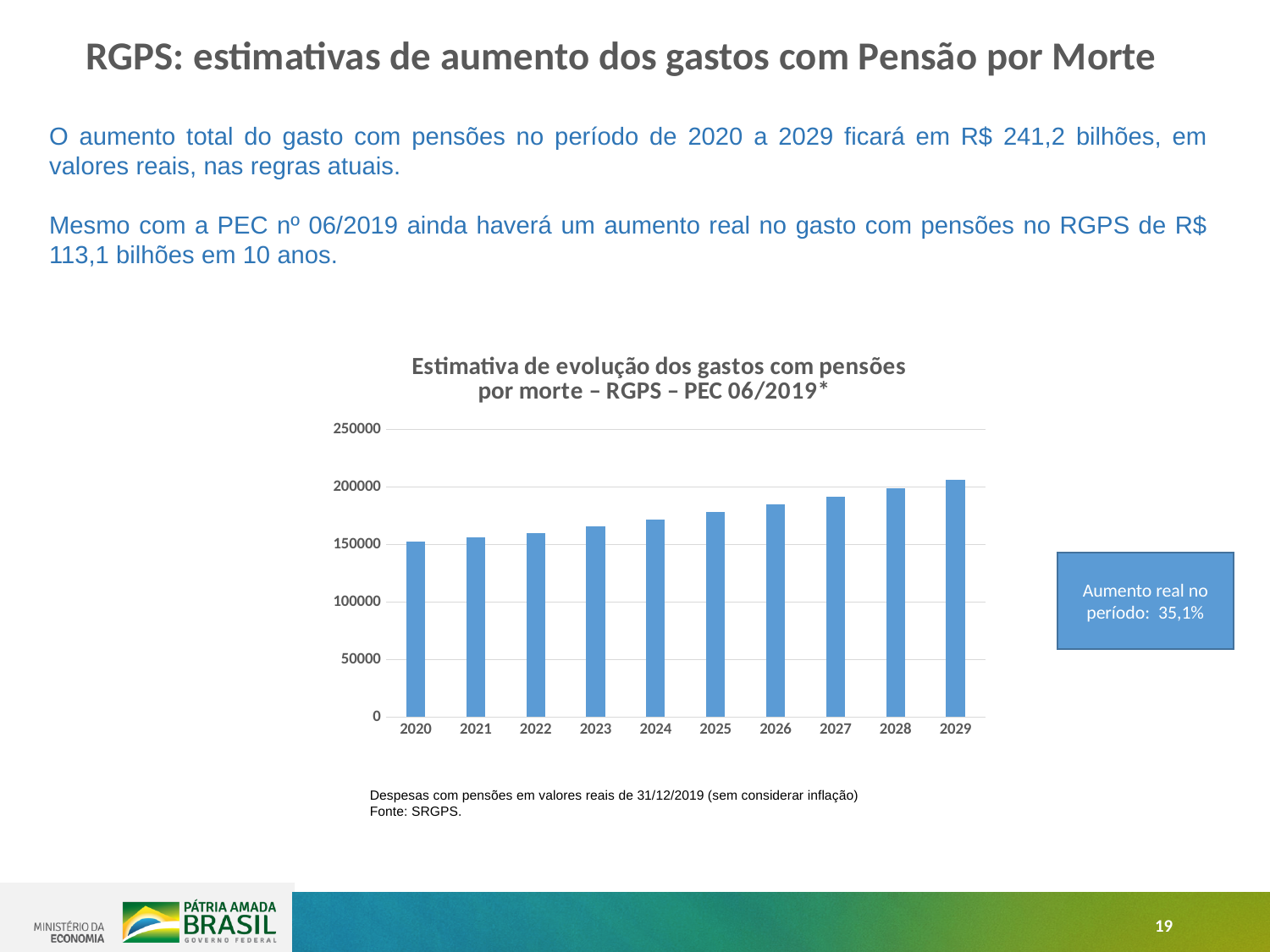
Is the value for 2029 greater or less than 200000? greater What is the title of the chart? Estimativa de evolução dos gastos com pensões por morte – RGPS – PEC 06/2019* Do the values rise or fall from 2020 to 2029? rise How many years are plotted on the x axis of the chart? 10 Which year has the lowest estimated spending in the chart? 2020 Is the value for 2024 greater or less than 150000? greater Is the value for 2027 greater or less than 200000? less What is the highest value shown on the chart's vertical axis? 250000 Which is larger, the value for 2026 or the value for 2021? 2026 Which year has the highest estimated spending in the chart? 2029 What kind of chart is shown on the slide? bar chart